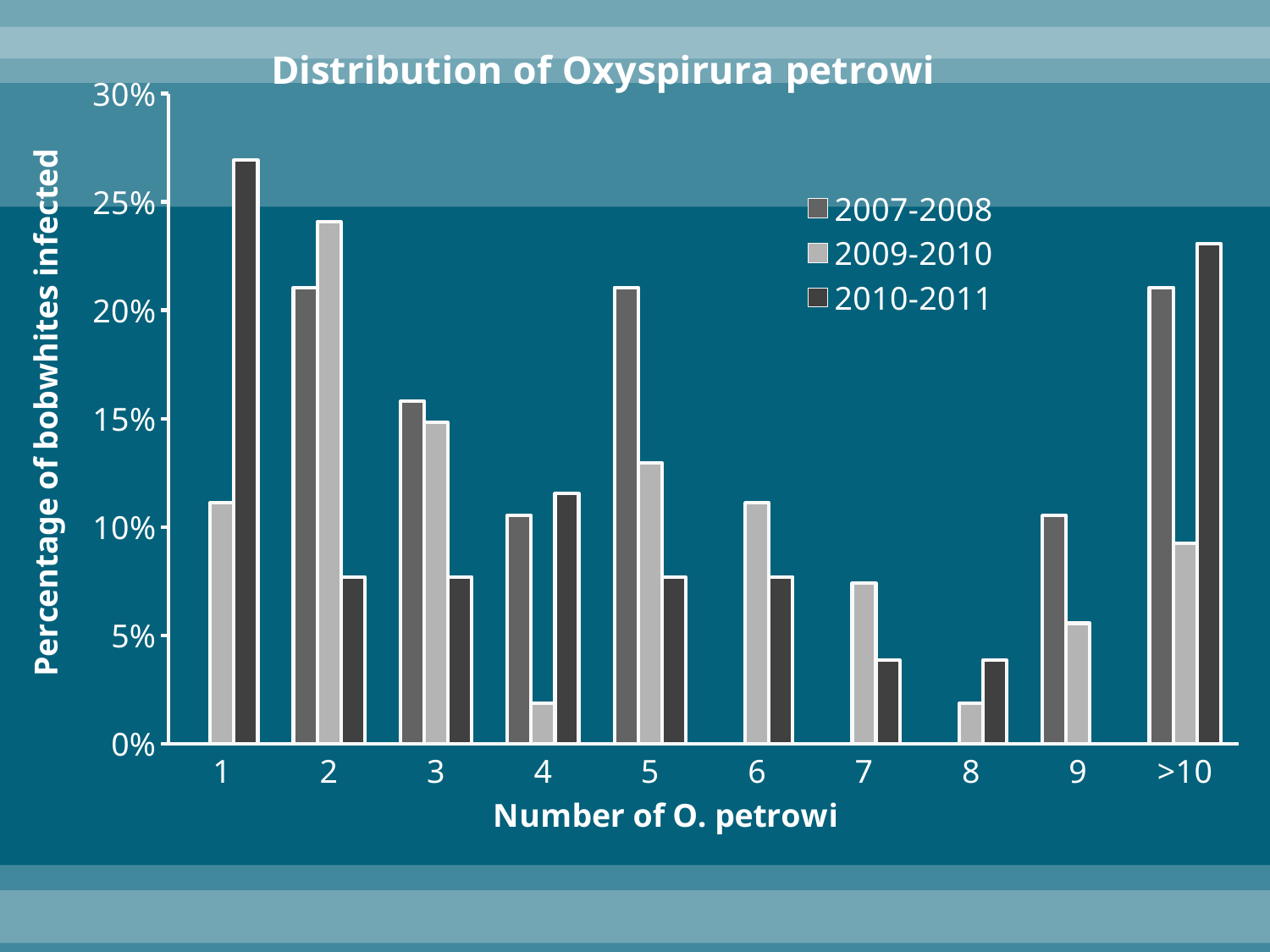
For category 2, which series has the larger value: 2007-2008 or 2009-2010? 2009-2010 Is the 2009-2010 value for category 4 greater or less than 5%? less For category 5, which series has the larger value: 2007-2008 or 2009-2010? 2007-2008 For the 2009-2010 series, which category has the highest percentage of bobwhites infected? 2 Is the 2007-2008 value for category >10 greater or less than 20%? greater For the 2010-2011 series, which category has the highest percentage of bobwhites infected? 1 How many series does the legend list? 3 What is the title of the chart? Distribution of Oxyspirura petrowi How many categories are shown on the x axis? 10 What is the label of the x axis? Number of O. petrowi Is the 2010-2011 value for category 1 greater or less than 25%? greater What type of chart is shown on the slide? Bar chart